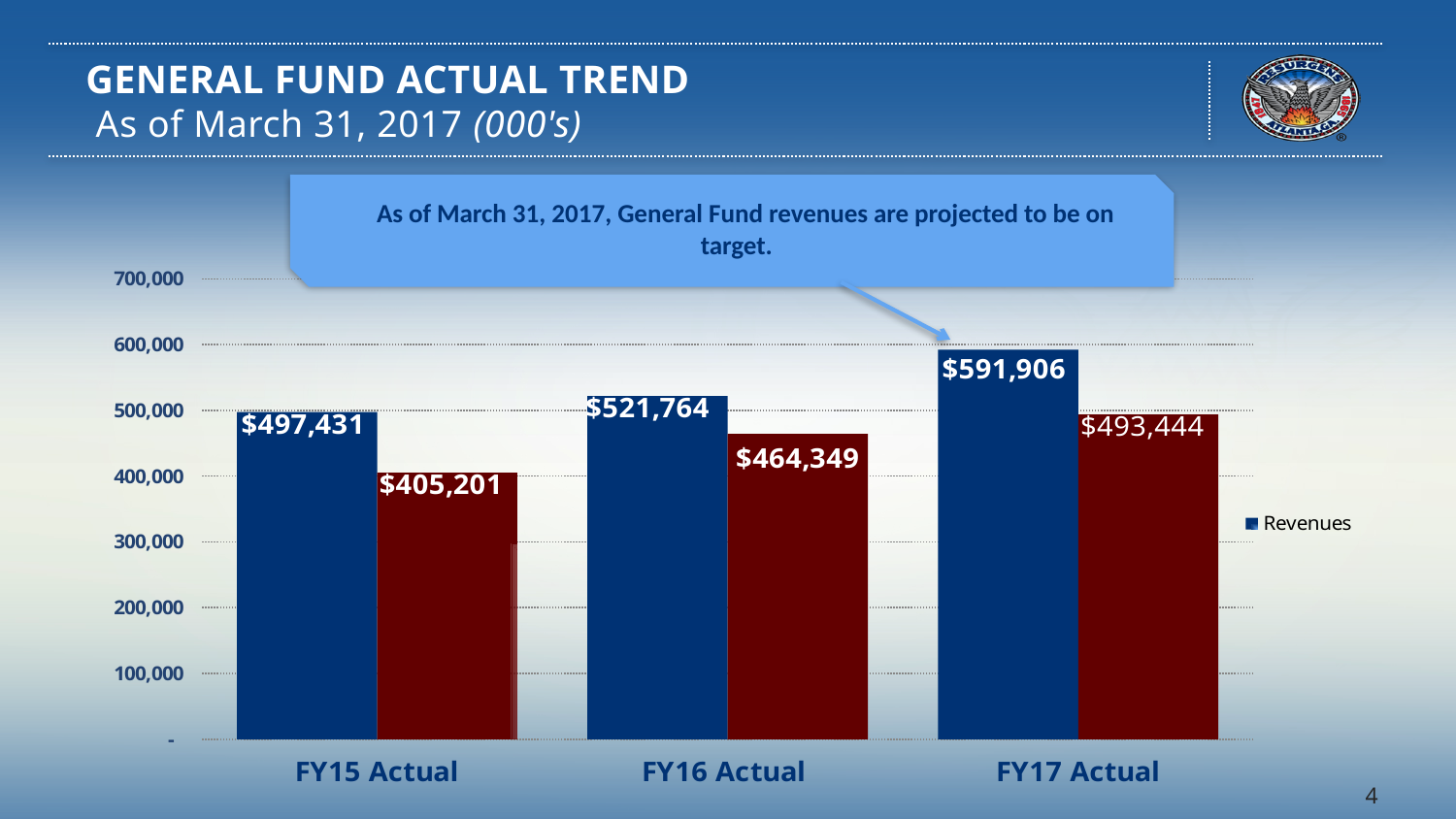
How many categories are shown on the x axis? 3 What is the Revenues value for FY17 Actual? $591,906 Which category has the highest Revenues value? FY17 Actual Is the Revenues value for FY17 Actual greater or less than 500,000? greater Which category has the lowest Revenues value? FY15 Actual What is the difference between the Revenues values for FY17 Actual and FY16 Actual? $70,142 What is the Revenues value for FY15 Actual? $497,431 What is the value of the dark red bar for FY16 Actual? $464,349 What kind of chart is shown on the slide? bar chart Do the Revenues values rise or fall from FY15 Actual to FY17 Actual? rise Which has the larger Revenues value, FY15 Actual or FY16 Actual? FY16 Actual What is the difference between the blue bar and the dark red bar for FY15 Actual? $92,230